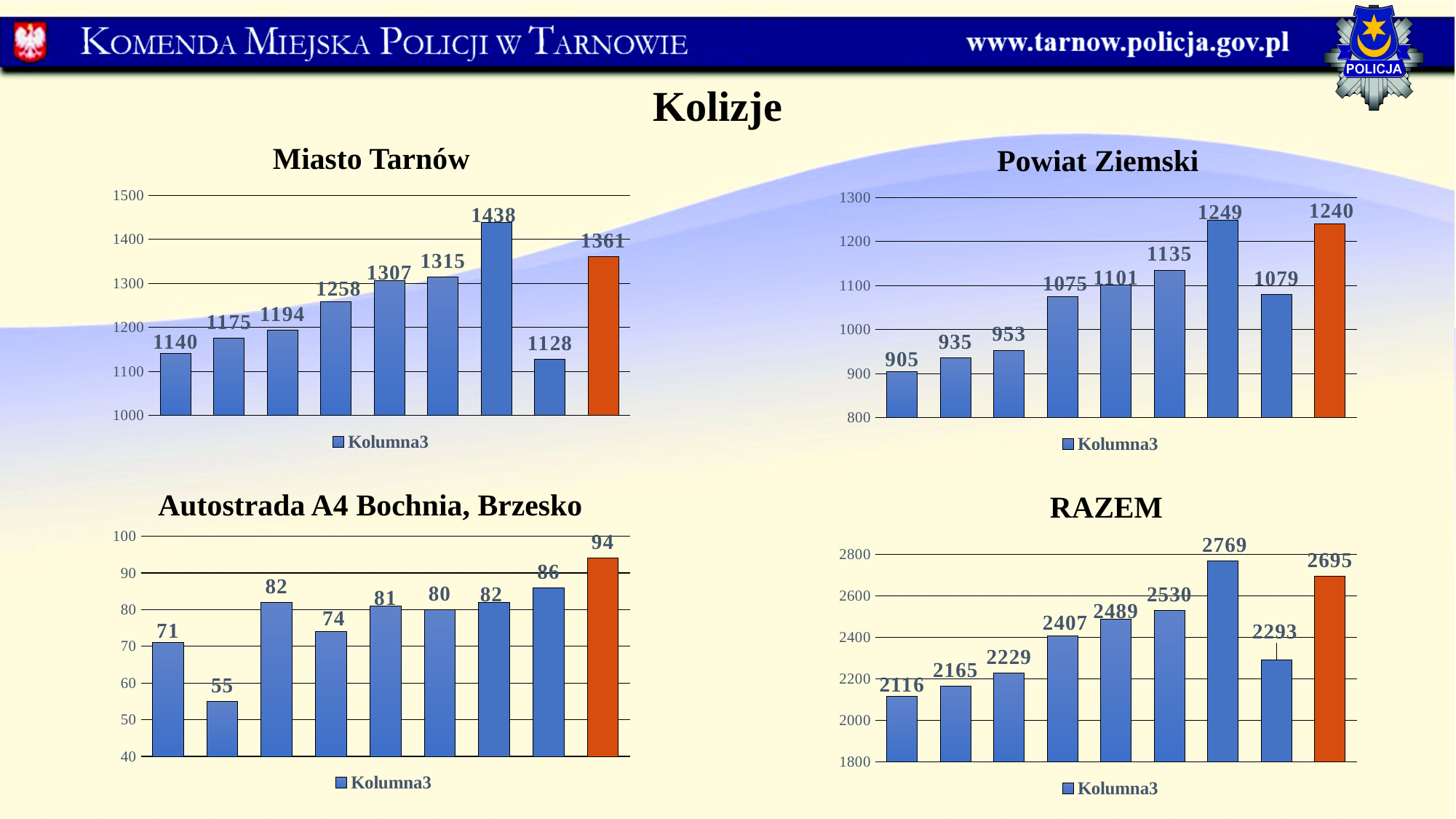
In the "Autostrada A4 Bochnia, Brzesko" chart, what is the value of the lowest bar? 55 In the "RAZEM" chart, what is the value of the highest bar? 2769 In the "Miasto Tarnów" chart, what is the value of the lowest bar? 1128 In the "Miasto Tarnów" chart, what is the value of the last (orange) bar? 1361 In the "Powiat Ziemski" chart, what is the difference between the highest bar (1249) and the last orange bar (1240)? 9 In the "Miasto Tarnów" chart, what is the value of the highest bar? 1438 In the "Powiat Ziemski" chart, what is the value of the first bar? 905 How many bars are plotted in the "RAZEM" chart? 9 In the "Autostrada A4 Bochnia, Brzesko" chart, what is the value of the last (orange) bar? 94 What legend entry is shown below the "Miasto Tarnów" chart? Kolumna3 In the "RAZEM" chart, what is the difference between the first bar (2116) and the last bar (2695)? 579 What type of chart is the "Powiat Ziemski" chart? Bar chart